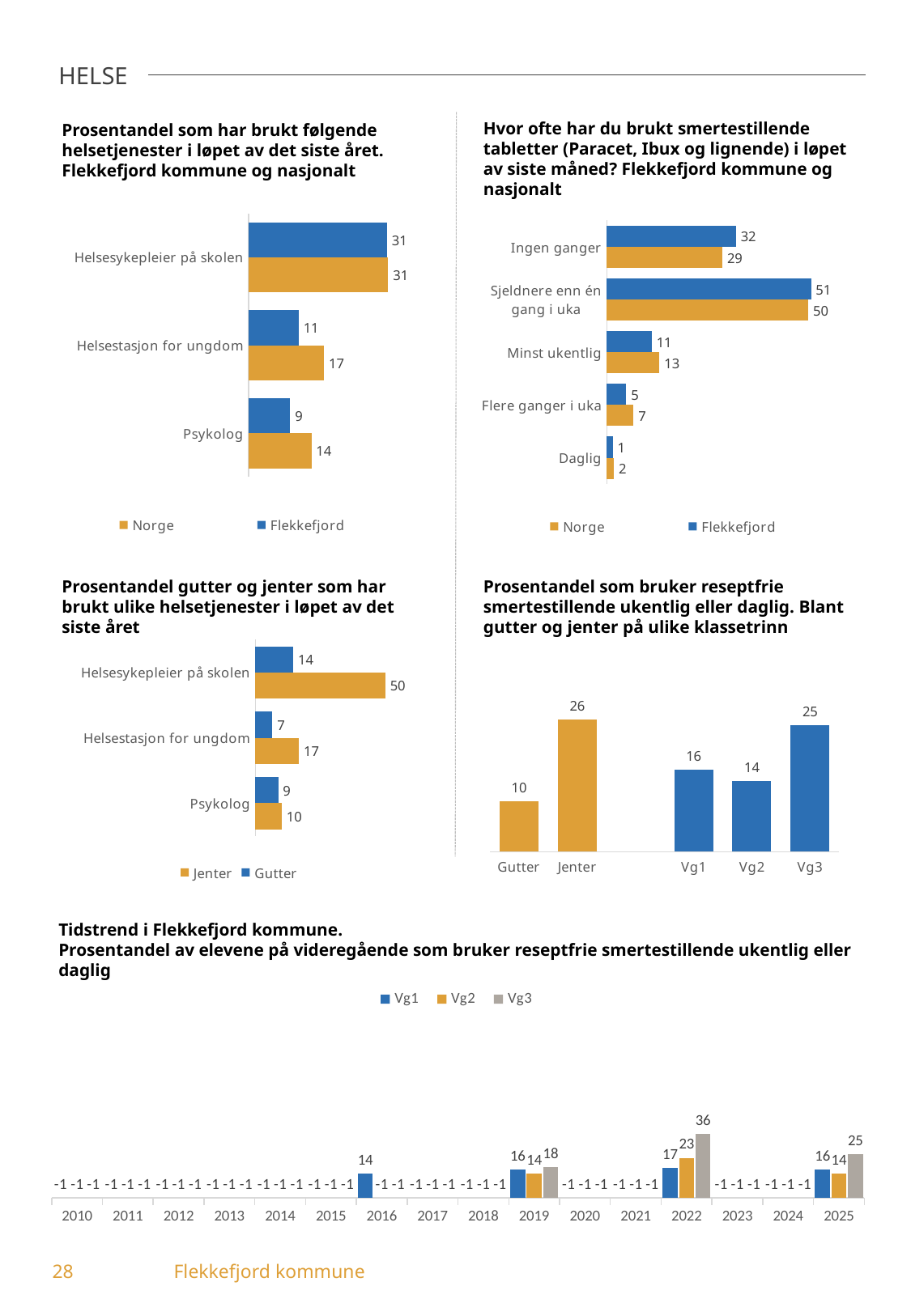
In the top-left chart (Prosentandel som har brukt følgende helsetjenester), what is the value for Flekkefjord for Helsestasjon for ungdom? 11 In the middle-right chart (Prosentandel som bruker reseptfrie smertestillende ukentlig eller daglig), what is the value for Vg3? 25 In the top-right chart (Hvor ofte har du brukt smertestillende tabletter), which category has the highest value for Flekkefjord? Sjeldnere enn én gang i uka In the middle-left chart (Prosentandel gutter og jenter som har brukt ulike helsetjenester), what is the value for Jenter for Helsesykepleier på skolen? 50 In the top-left chart (Prosentandel som har brukt følgende helsetjenester), what is the difference between the Norge and Flekkefjord values for Psykolog? 5 In the top-right chart (Hvor ofte har du brukt smertestillende tabletter), what is the Norge value for Minst ukentlig? 13 In the middle-left chart (Prosentandel gutter og jenter som har brukt ulike helsetjenester), which is larger for Helsestasjon for ungdom: Gutter or Jenter? Jenter In the top-right chart (Hvor ofte har du brukt smertestillende tabletter), how many categories are shown? 5 What kind of chart is the bottom chart (Tidstrend i Flekkefjord kommune)? Bar chart In the middle-right chart (Prosentandel som bruker reseptfrie smertestillende ukentlig eller daglig), which category has the lowest value? Gutter In the bottom chart (Tidstrend i Flekkefjord kommune), what is the Vg3 value for 2022? 36 In the bottom chart (Tidstrend i Flekkefjord kommune), how many series does the legend list? 3